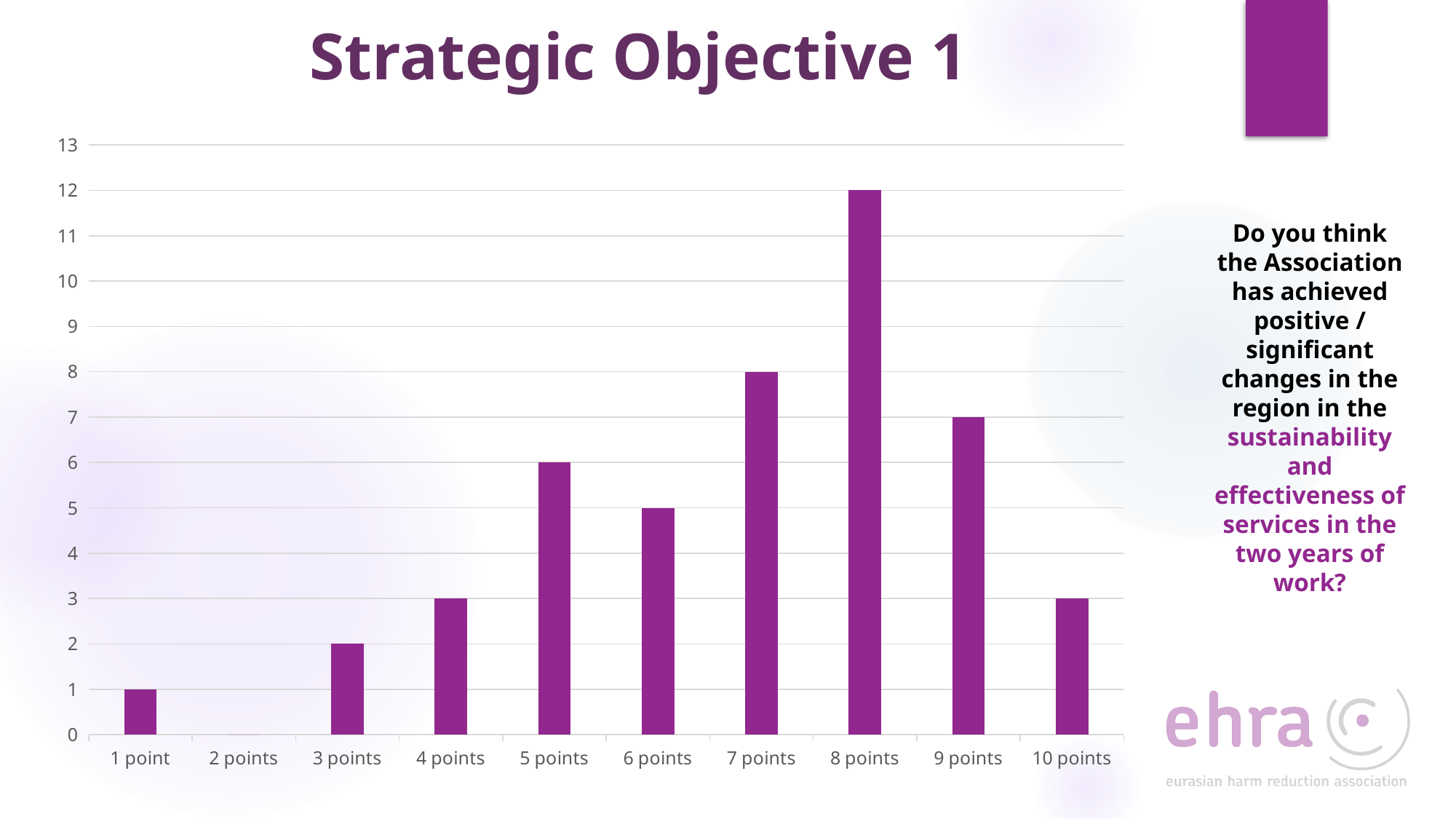
Which category has no bar at all in the chart? 2 points What is the value for 7 points? 8 What is the value for 1 point? 1 What is the difference between the values for 8 points and 9 points? 5 What is the value for 5 points? 6 What kind of chart is shown on the slide? bar chart Is the value for 9 points greater or less than 5? greater How many categories are shown on the x axis of the chart? 10 Which is larger, the value for 5 points or the value for 6 points? 5 points Which category has the highest value in the chart? 8 points What is the title of the slide containing the chart? Strategic Objective 1 What is the value for 8 points? 12